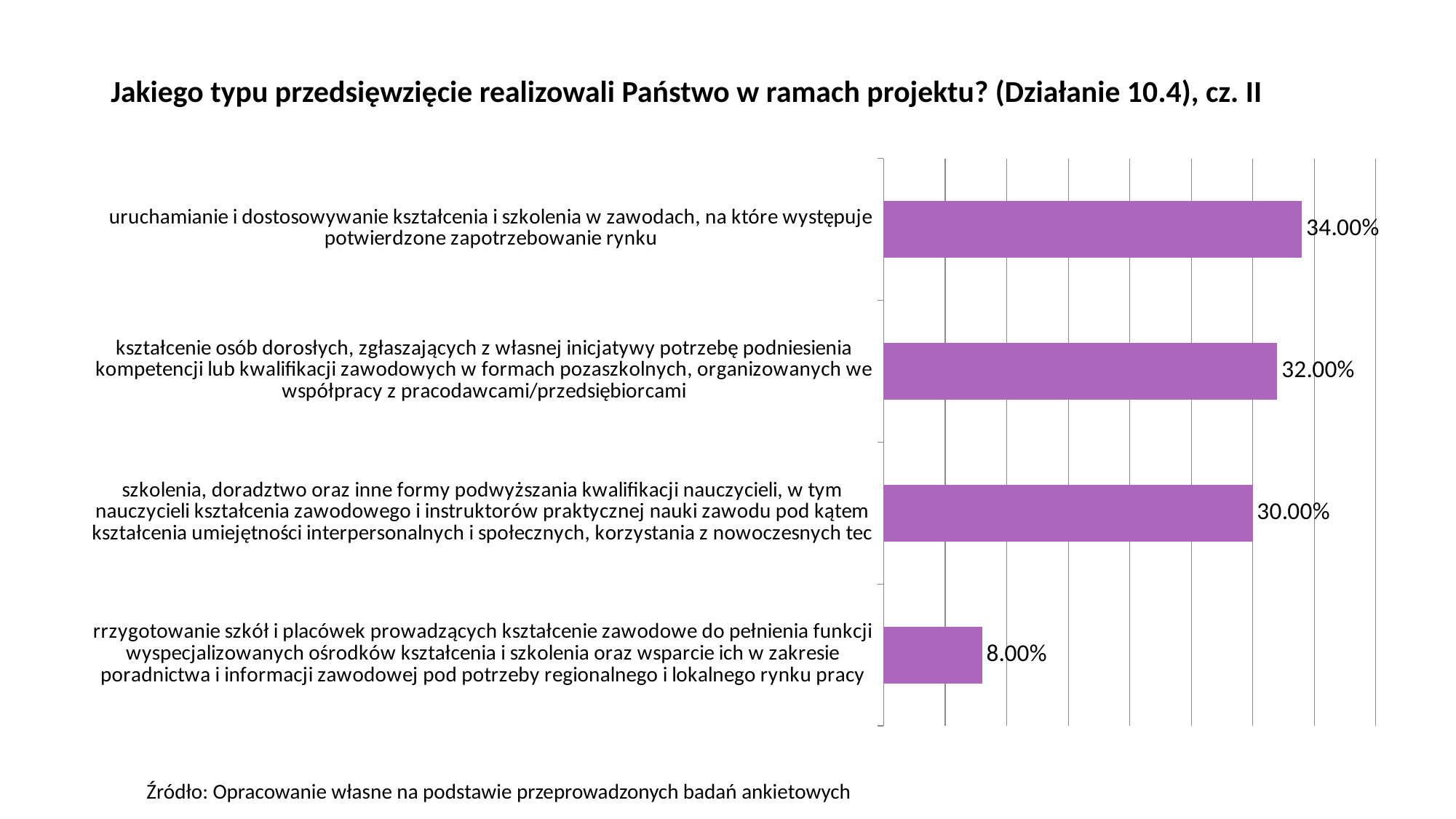
What type of chart is shown on the slide? bar chart What is the difference between the values for "kształcenie osób dorosłych..." (32.00%) and "szkolenia, doradztwo oraz inne formy podwyższania kwalifikacji nauczycieli..." (30.00%)? 2.00% What is the value for "szkolenia, doradztwo oraz inne formy podwyższania kwalifikacji nauczycieli..."? 30.00% Which category has the highest value? uruchamianie i dostosowywanie kształcenia i szkolenia w zawodach, na które występuje potwierdzone zapotrzebowanie rynku What is the title of the chart? Jakiego typu przedsięwzięcie realizowali Państwo w ramach projektu? (Działanie 10.4), cz. II What is the value for "rrzygotowanie szkół i placówek prowadzących kształcenie zawodowe do pełnienia funkcji wyspecjalizowanych ośrodków kształcenia i szkolenia..."? 8.00% How many categories are plotted in the chart? 4 Which is larger: the value for "szkolenia, doradztwo oraz inne formy podwyższania kwalifikacji nauczycieli..." or the value for "rrzygotowanie szkół i placówek prowadzących kształcenie zawodowe..."? szkolenia, doradztwo oraz inne formy podwyższania kwalifikacji nauczycieli... What is the value for "uruchamianie i dostosowywanie kształcenia i szkolenia w zawodach, na które występuje potwierdzone zapotrzebowanie rynku"? 34.00% What is the value for "kształcenie osób dorosłych, zgłaszających z własnej inicjatywy potrzebę podniesienia kompetencji lub kwalifikacji zawodowych..."? 32.00% What is the difference between the highest value (34.00%) and the lowest value (8.00%)? 26.00%